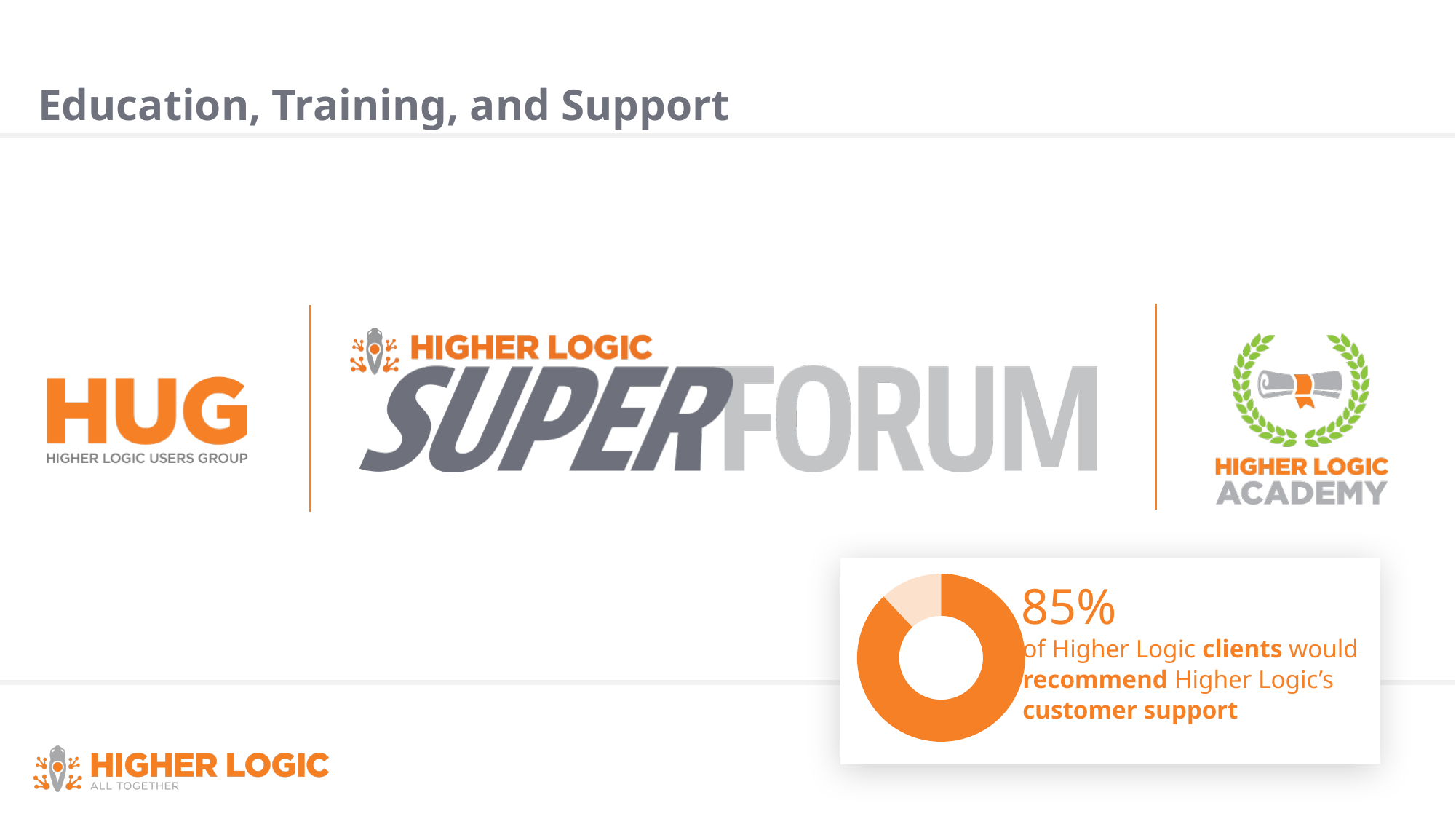
What does the 85% figure next to the donut chart describe? Higher Logic clients who would recommend Higher Logic's customer support How many slices does the donut chart have? 2 What percentage of Higher Logic clients would recommend Higher Logic's customer support, according to the donut chart? 85% What colour is the slice representing the 85% of clients in the donut chart? Orange Which slice of the donut chart is larger, the dark orange slice or the light slice? The dark orange slice What kind of chart is shown in the box at the bottom right of the slide? Donut (pie) chart Is the share of clients who would recommend Higher Logic's customer support greater or less than 50%? greater